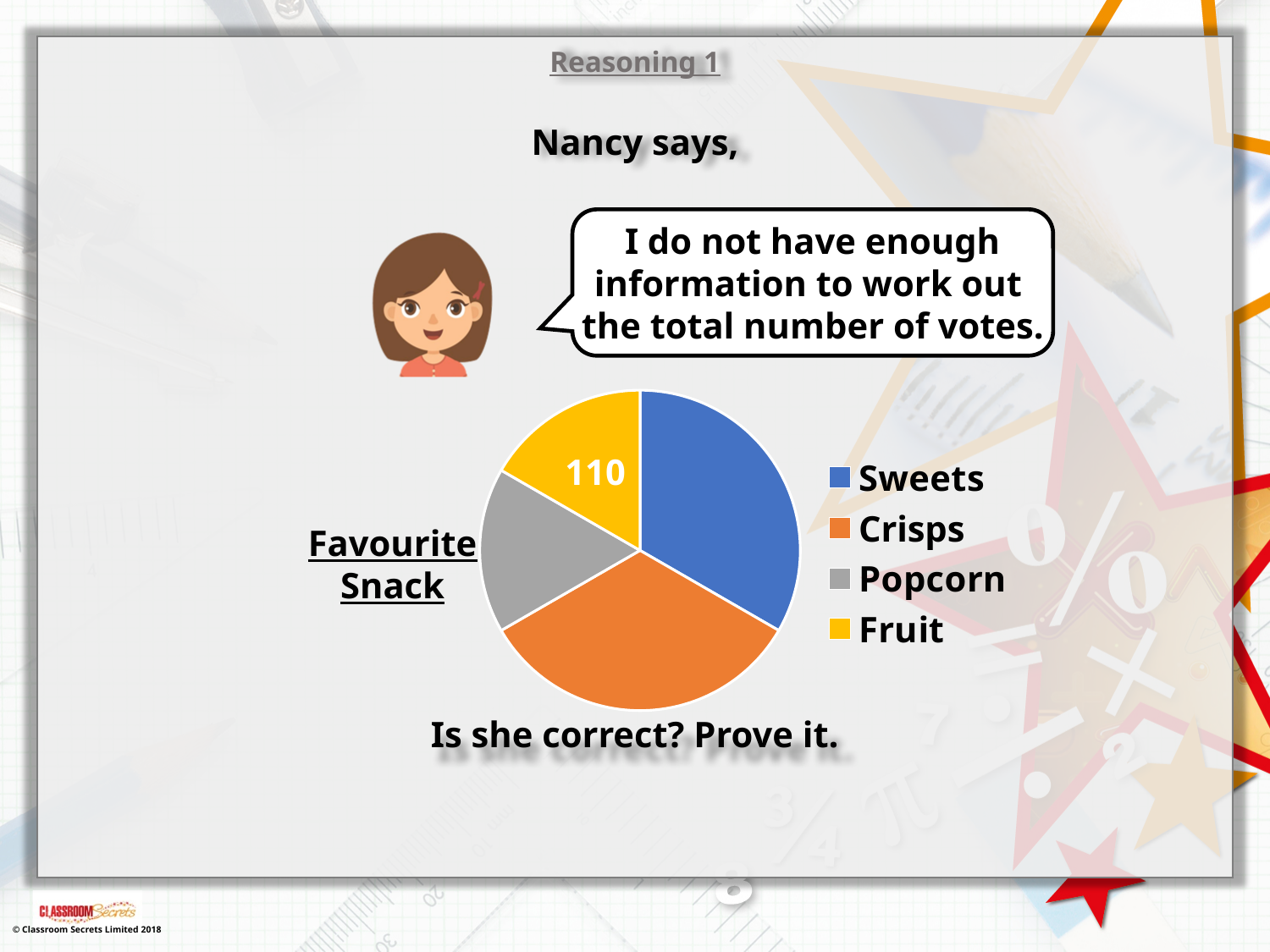
What kind of chart is shown on the slide? pie chart What value is printed on the Fruit slice of the pie chart? 110 Which slice of the pie chart is larger, Sweets or Fruit? Sweets Which category is the only one with a value printed on its slice? Fruit Which slice of the pie chart is larger, Popcorn or Sweets? Sweets Which slice of the pie chart is larger, Crisps or Fruit? Crisps What is the title of the chart? Favourite Snack How many entries does the legend list? 4 How many categories does the pie chart have? 4 What colour represents Popcorn in the pie chart? grey